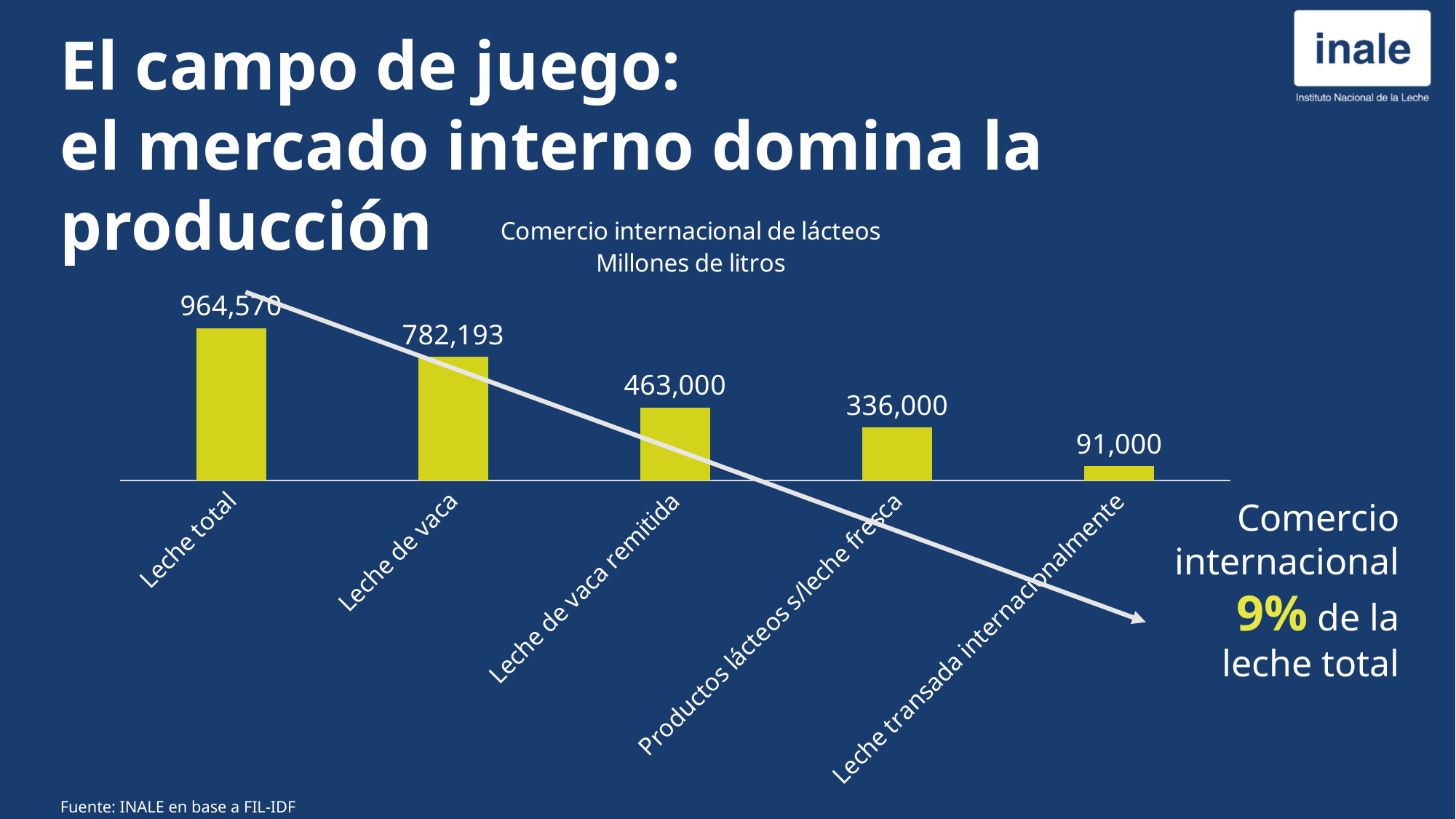
Which is larger, Leche de vaca remitida or Productos lácteos s/leche fresca? Leche de vaca remitida What is the difference between Leche total and Leche de vaca? 182,377 What is the value for Productos lácteos s/leche fresca? 336,000 What is the difference between Productos lácteos s/leche fresca and Leche transada internacionalmente? 245,000 Do the values rise or fall from left to right along the x axis? Fall Which category has the lowest value? Leche transada internacionalmente What is the value for Leche total? 964,570 What kind of chart is shown on the slide? Bar chart Which category has the highest value? Leche total How many categories are shown in the chart? 5 What is the value for Leche transada internacionalmente? 91,000 What is the value for Leche de vaca remitida? 463,000